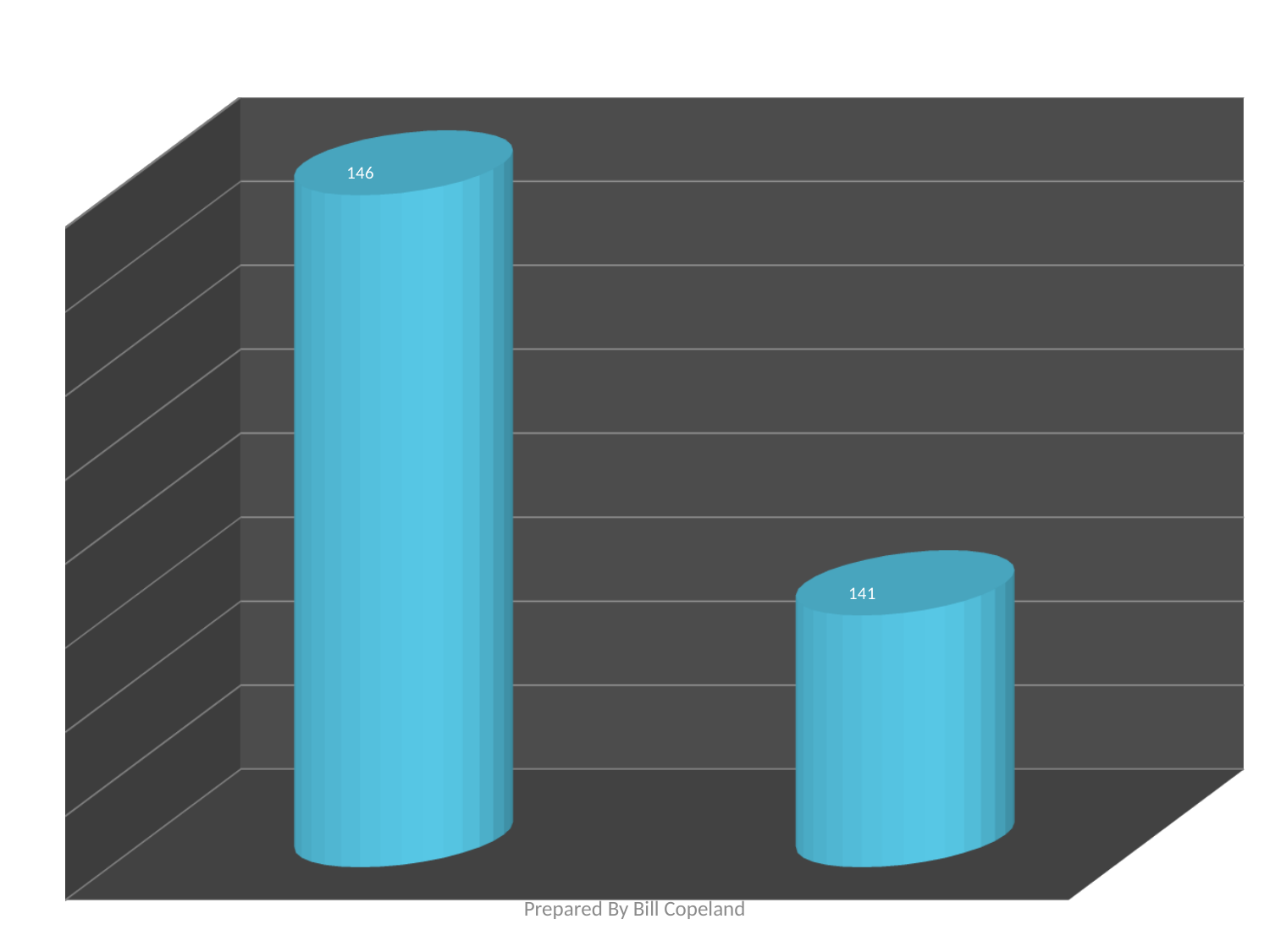
How many bars are plotted on the chart? 2 What is the difference between the values of the left bar and the right bar? 5 Do the values rise or fall from the left bar to the right bar? fall What is the total of the two bar values? 287 Which bar has the higher value, the left or the right? left What value is printed on the right bar? 141 What value is printed on the left bar? 146 Which bar has the lower value, the left or the right? right What text appears below the chart at the bottom of the slide? Prepared By Bill Copeland What colour are the bars on the chart? blue What kind of chart is shown on the slide? bar chart Is the value of the left bar larger or smaller than the value of the right bar? larger